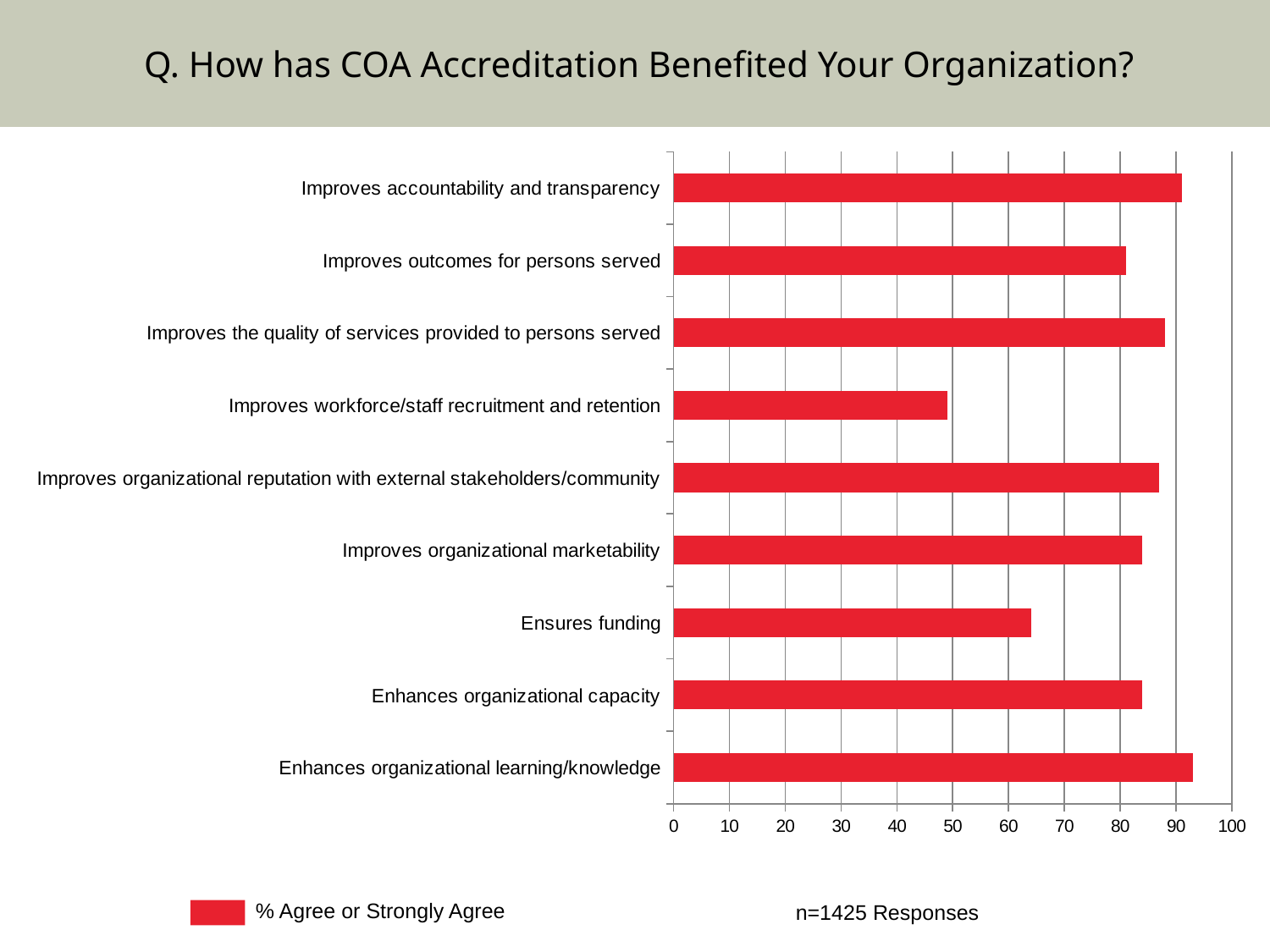
How many responses does the slide say the chart is based on? n=1425 Responses Is the value for 'Improves workforce/staff recruitment and retention' greater or less than 40? greater How many series does the legend list? 1 How many categories (benefits) are plotted on the chart? 9 What does the legend say the bars represent? % Agree or Strongly Agree Is the value for 'Improves the quality of services provided to persons served' greater or less than 80? greater Which category has the lowest value on the chart? Improves workforce/staff recruitment and retention Which is larger: the value for 'Ensures funding' or the value for 'Improves workforce/staff recruitment and retention'? Ensures funding Which is larger: the value for 'Improves the quality of services provided to persons served' or the value for 'Improves outcomes for persons served'? Improves the quality of services provided to persons served What kind of chart is shown on the slide? bar chart Is the value for 'Improves organizational reputation with external stakeholders/community' greater or less than 90? less